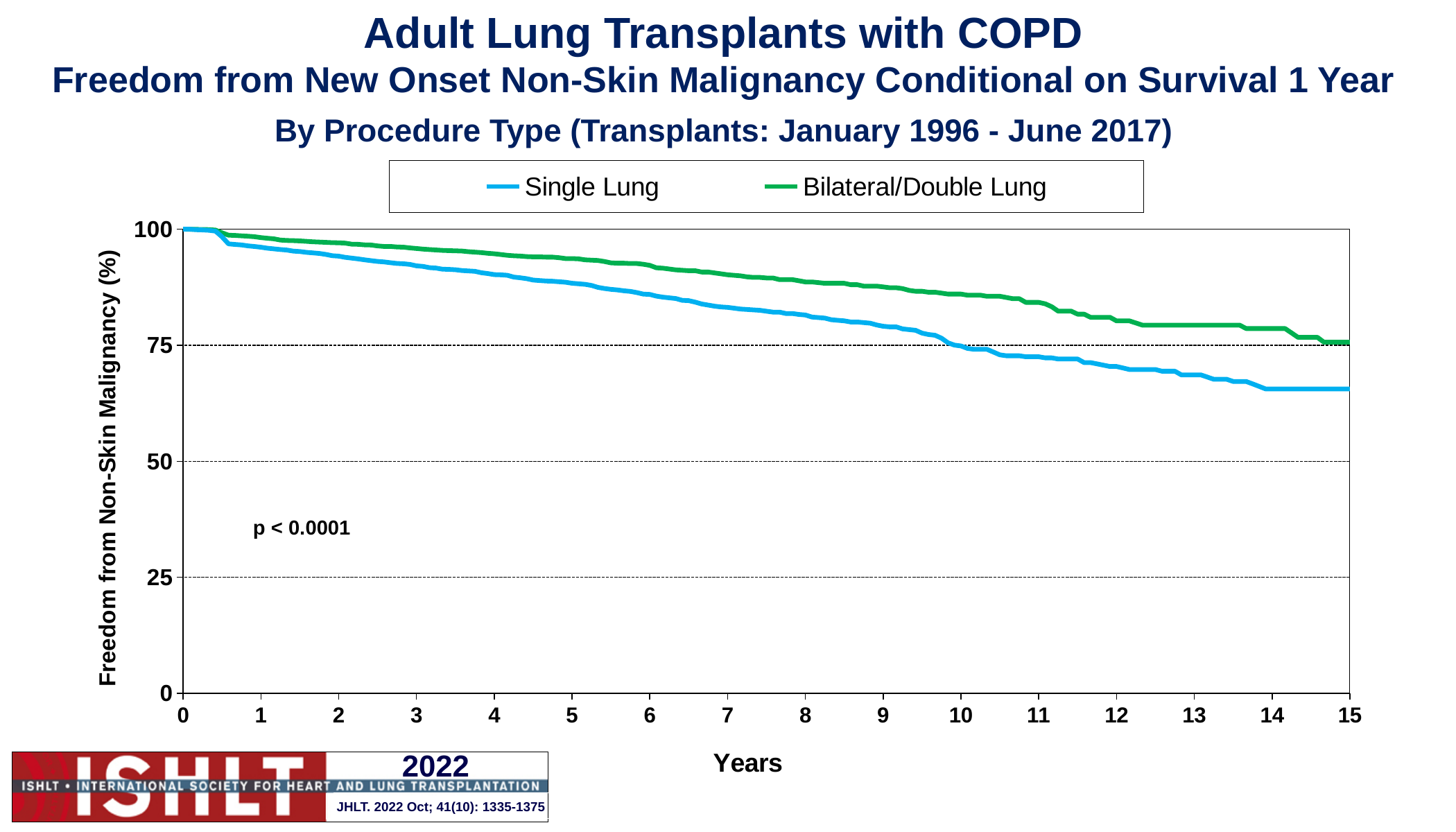
At 15 years, which series has the higher freedom from non-skin malignancy, Single Lung or Bilateral/Double Lung? Bilateral/Double Lung How many series does the legend list? 2 Do the values for Single Lung rise or fall as years increase along the x axis? Fall What p-value is printed on the chart? p < 0.0001 Is the value for Single Lung at 14 years greater or less than 75? less Is the value for Single Lung at 5 years greater or less than 75? greater Which two series are listed in the legend? Single Lung and Bilateral/Double Lung At 10 years, which series has the higher freedom from non-skin malignancy, Single Lung or Bilateral/Double Lung? Bilateral/Double Lung Is the value for Single Lung at 15 years greater or less than 75? less What kind of chart is shown on the slide? Line chart Do the values for Bilateral/Double Lung rise or fall as years increase along the x axis? Fall